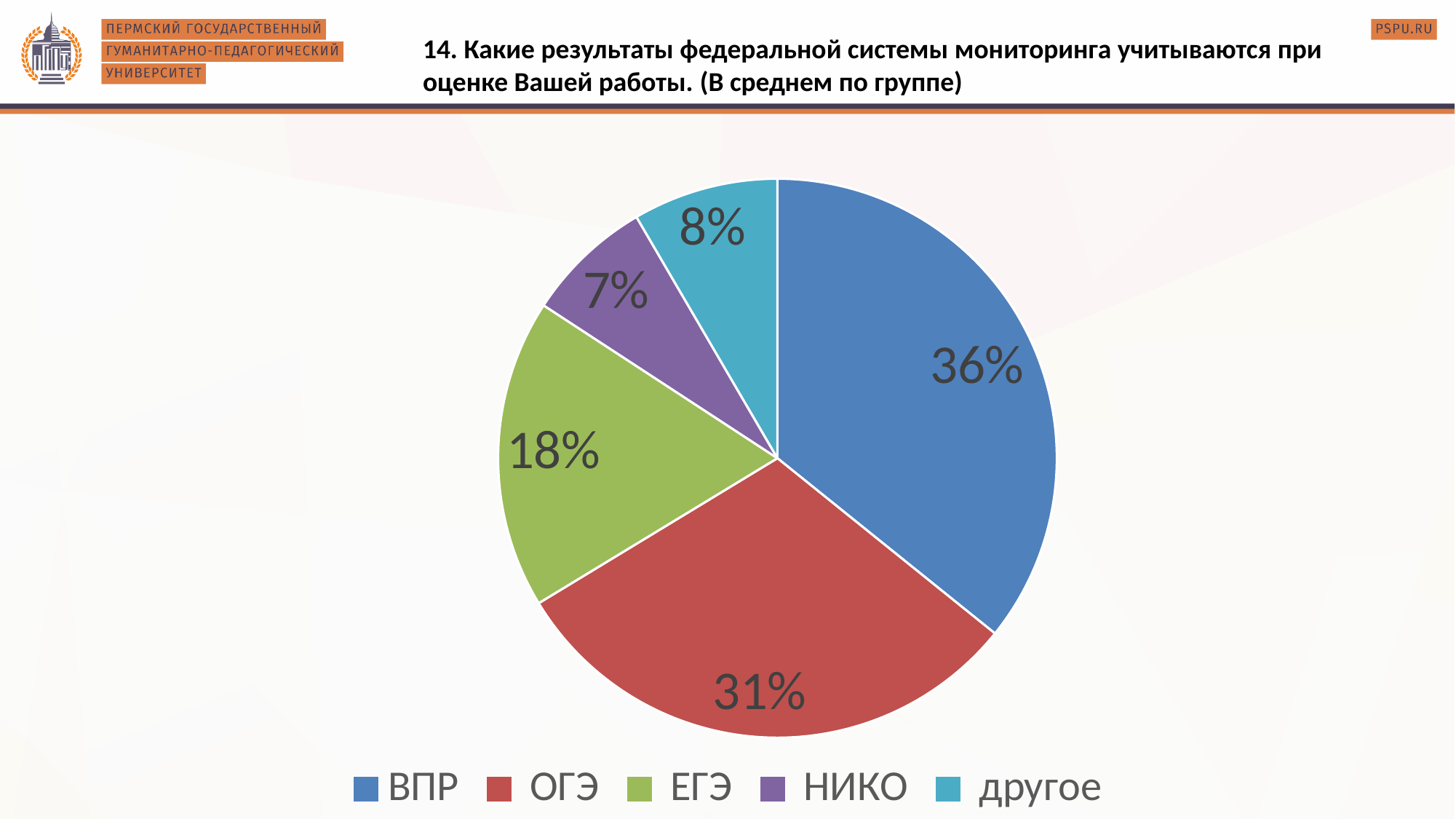
What share of the pie does НИКО have? 7% What colour is the slice for ОГЭ? red What share of the pie does ВПР have? 36% Which is larger, the share for ЕГЭ or the share for другое? ЕГЭ Which category has the smallest slice of the pie? НИКО What share of the pie does ОГЭ have? 31% Which category has the largest slice of the pie? ВПР What is the difference in percentage points between ВПР and ОГЭ? 5 What kind of chart is shown on the slide? pie chart How many categories does the legend list? 5 What share of the pie does ЕГЭ have? 18% What share of the pie does другое have? 8%